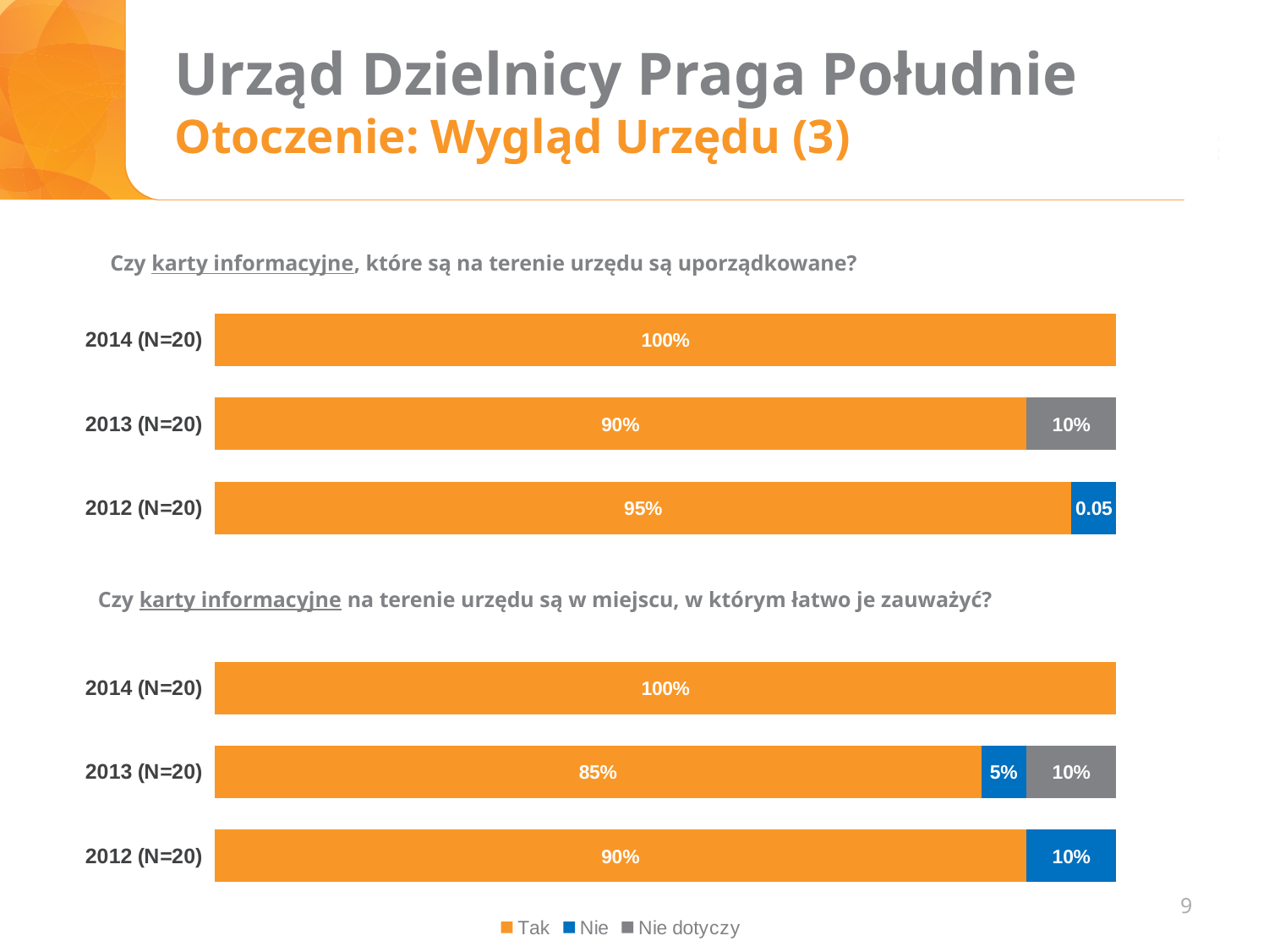
In the top chart, what label is printed on the blue "Nie" segment for 2012 (N=20)? 0.05 In the top chart, what is the value for "Nie dotyczy" in 2013 (N=20)? 10% How many series does the legend at the bottom of the slide list? 3 In the bottom chart, which year has the lowest "Tak" value? 2013 (N=20) In the bottom chart, what is the difference between the "Tak" values for 2014 (N=20) and 2013 (N=20)? 15% In the bottom chart ("Czy karty informacyjne na terenie urzędu są w miejscu, w którym łatwo je zauważyć?"), what is the value for "Tak" in 2013 (N=20)? 85% In the bottom chart, is the "Tak" value for 2012 (N=20) larger or smaller than the "Tak" value for 2013 (N=20)? larger In the bottom chart, what is the value for "Nie" in 2012 (N=20)? 10% In the top chart ("Czy karty informacyjne, które są na terenie urzędu są uporządkowane?"), what is the value for "Tak" in 2013 (N=20)? 90% In the top chart, which year has the highest "Tak" value? 2014 (N=20) In the top chart, what is the difference between the "Tak" values for 2012 (N=20) and 2013 (N=20)? 5% What type of chart is used for the top chart on the slide? Stacked bar chart